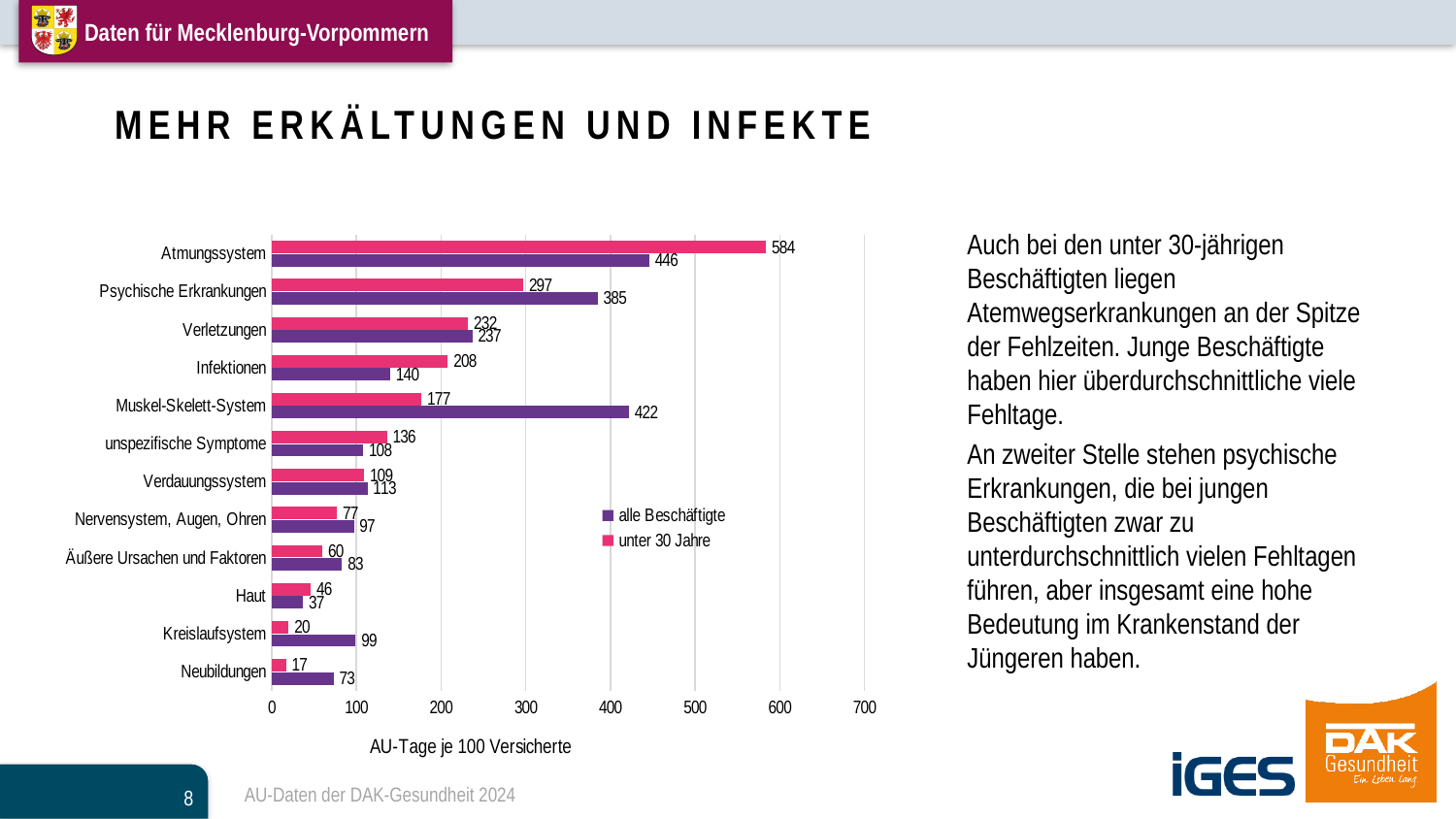
For Psychische Erkrankungen, which series has the larger value: 'alle Beschäftigte' or 'unter 30 Jahre'? alle Beschäftigte Which category has the lowest value for the 'alle Beschäftigte' series? Haut What is the label of the x axis? AU-Tage je 100 Versicherte How many categories are shown on the chart? 12 Which category has the highest value for the 'unter 30 Jahre' series? Atmungssystem What is the value for 'alle Beschäftigte' in the Kreislaufsystem category? 99 What is the difference between the 'unter 30 Jahre' and 'alle Beschäftigte' values for Atmungssystem? 138 What kind of chart is shown on the slide? Bar chart What is the value for 'alle Beschäftigte' in the Muskel-Skelett-System category? 422 How many series does the legend list? 2 Is the 'alle Beschäftigte' value for Muskel-Skelett-System greater or less than 400? greater What is the value for 'unter 30 Jahre' in the Atmungssystem category? 584